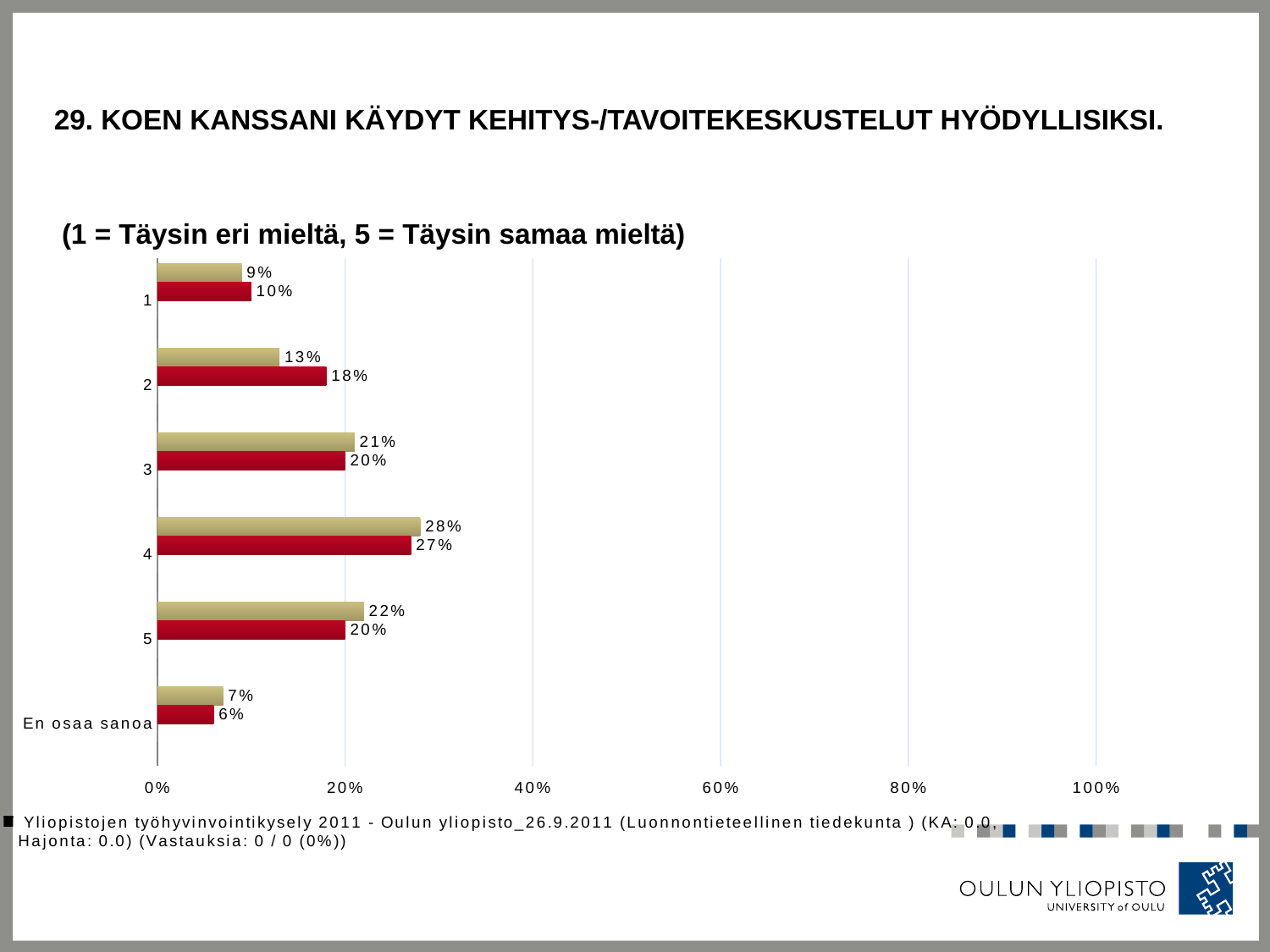
Is the value of the red bar for category 4 greater or less than 20%? greater How many categories are shown on the vertical axis of the chart? 6 For category 3, which is larger: the tan (gold) bar or the red bar? the tan (gold) bar What is the difference between the red bar and the tan (gold) bar for category 2? 5% What is the value of the tan (gold) bar for category 5? 22% What is the value of the red bar for category 2? 18% What type of chart is shown on the slide? bar chart What is the value of the tan (gold) bar for category 4? 28% Which category has the lowest value for the tan (gold) bars? En osaa sanoa What is the value of the red bar for 'En osaa sanoa'? 6% What is the highest value shown on the horizontal axis of the chart? 100% Which category has the highest value for the red bars? 4